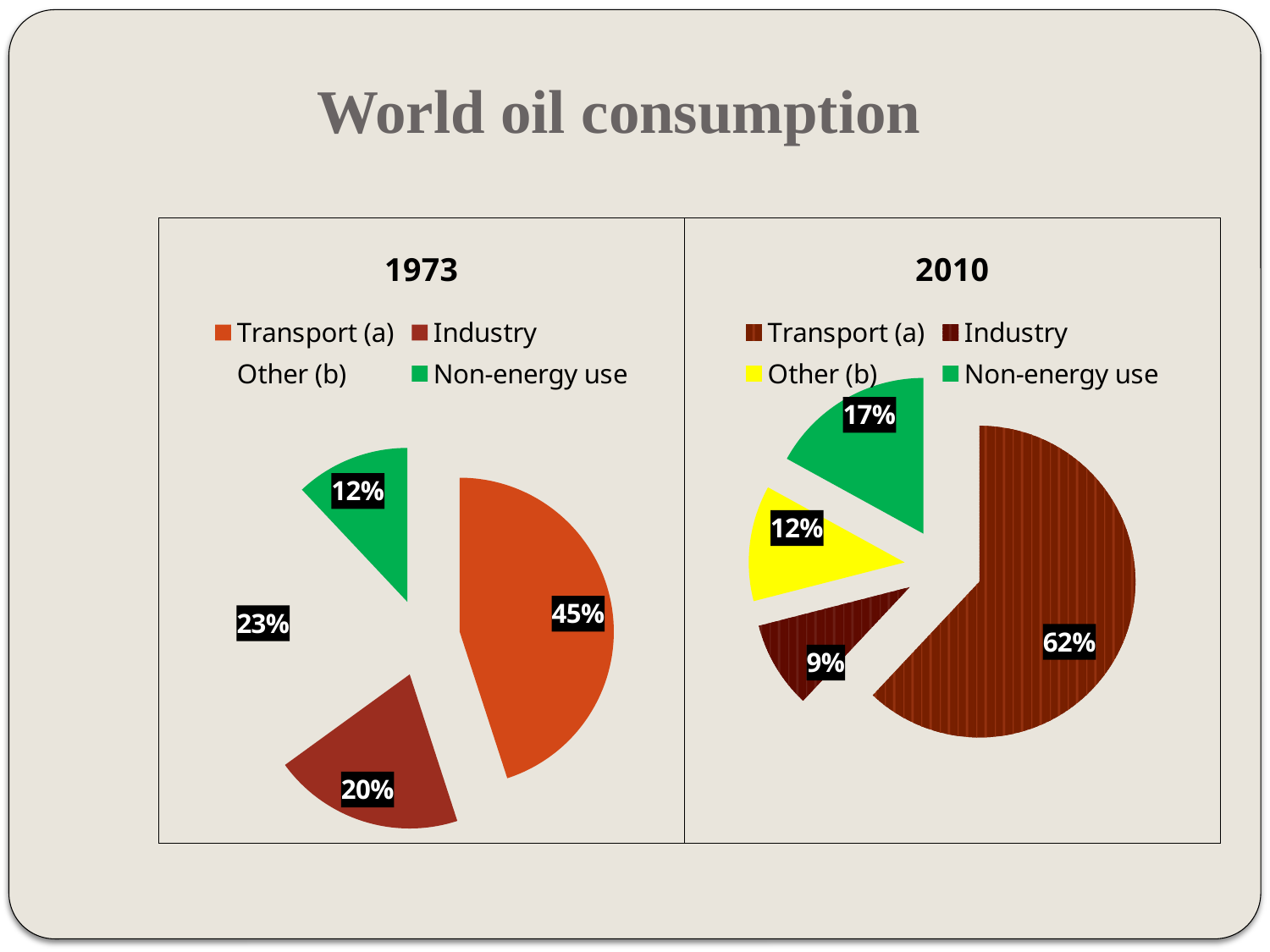
How many categories does the legend of the 2010 pie chart list? 4 What type of chart is used for the 1973 data? Pie chart In the 1973 pie chart, which category has the largest share? Transport (a) In the 2010 pie chart, what share does Non-energy use have? 17% In the 1973 pie chart, what share does Industry have? 20% In the 2010 pie chart, which category has the smallest share? Industry In the 1973 pie chart, which category has the smallest share? Non-energy use What is the title of the slide containing the two pie charts? World oil consumption In the 2010 pie chart, which is larger: Other (b) or Industry? Other (b) What is the difference between the Transport (a) share in 2010 and in 1973? 17% In the 2010 pie chart, what share does Transport (a) have? 62% In the 1973 pie chart, what share does Transport (a) have? 45%